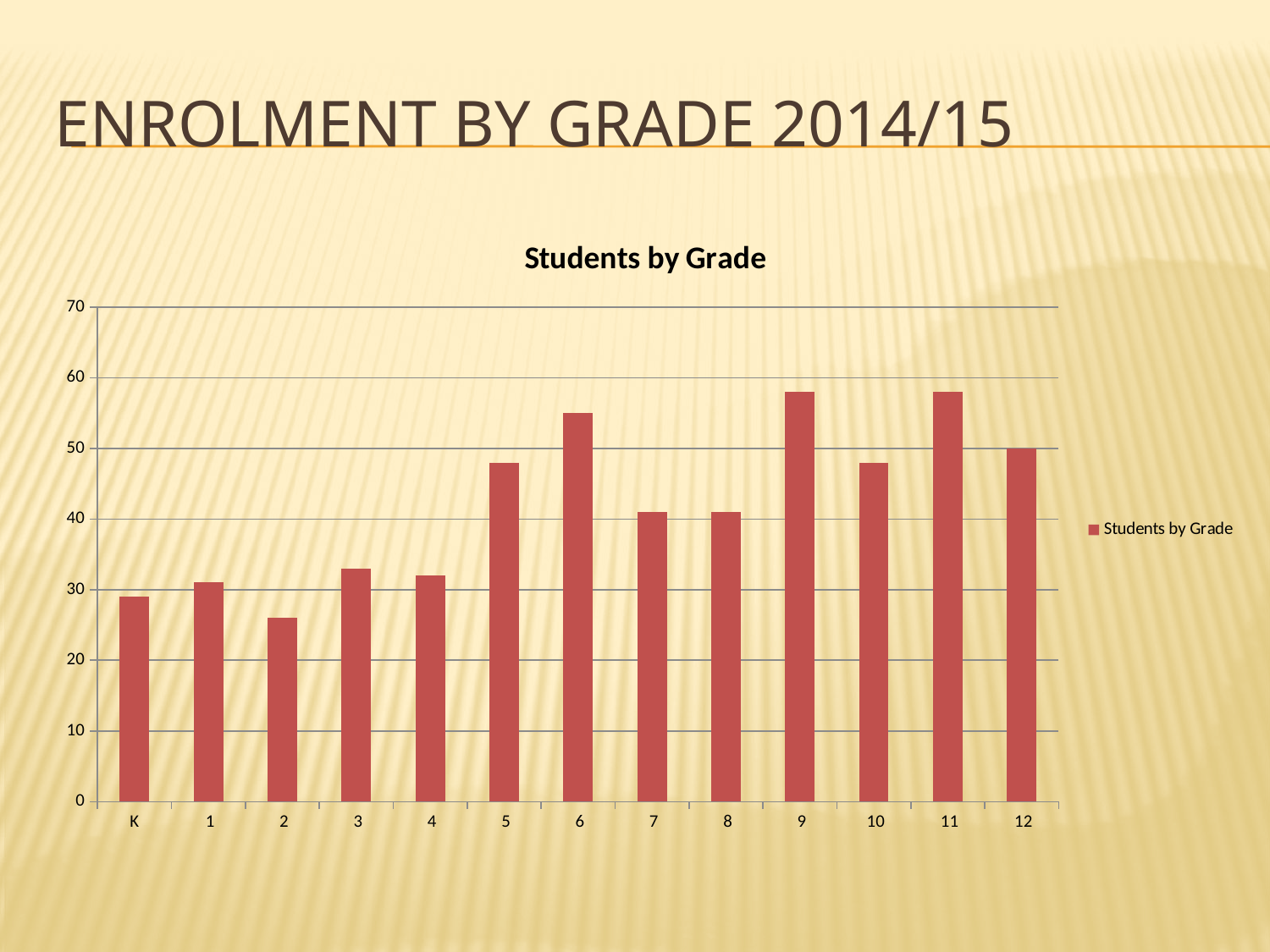
Is the value for grade 7 greater or less than 50? less Is the value for grade 2 greater or less than 30? less How many grade categories are shown on the x axis? 13 Is the value for grade 6 greater or less than 50? greater Which grade has the lowest enrolment? 2 Which has the larger value, grade 5 or grade 4? 5 What kind of chart is shown on the slide? bar chart Which has the larger value, grade 11 or grade 10? 11 What is the name of the series shown in the legend? Students by Grade What is the title of the chart? Students by Grade How many series does the legend list? 1